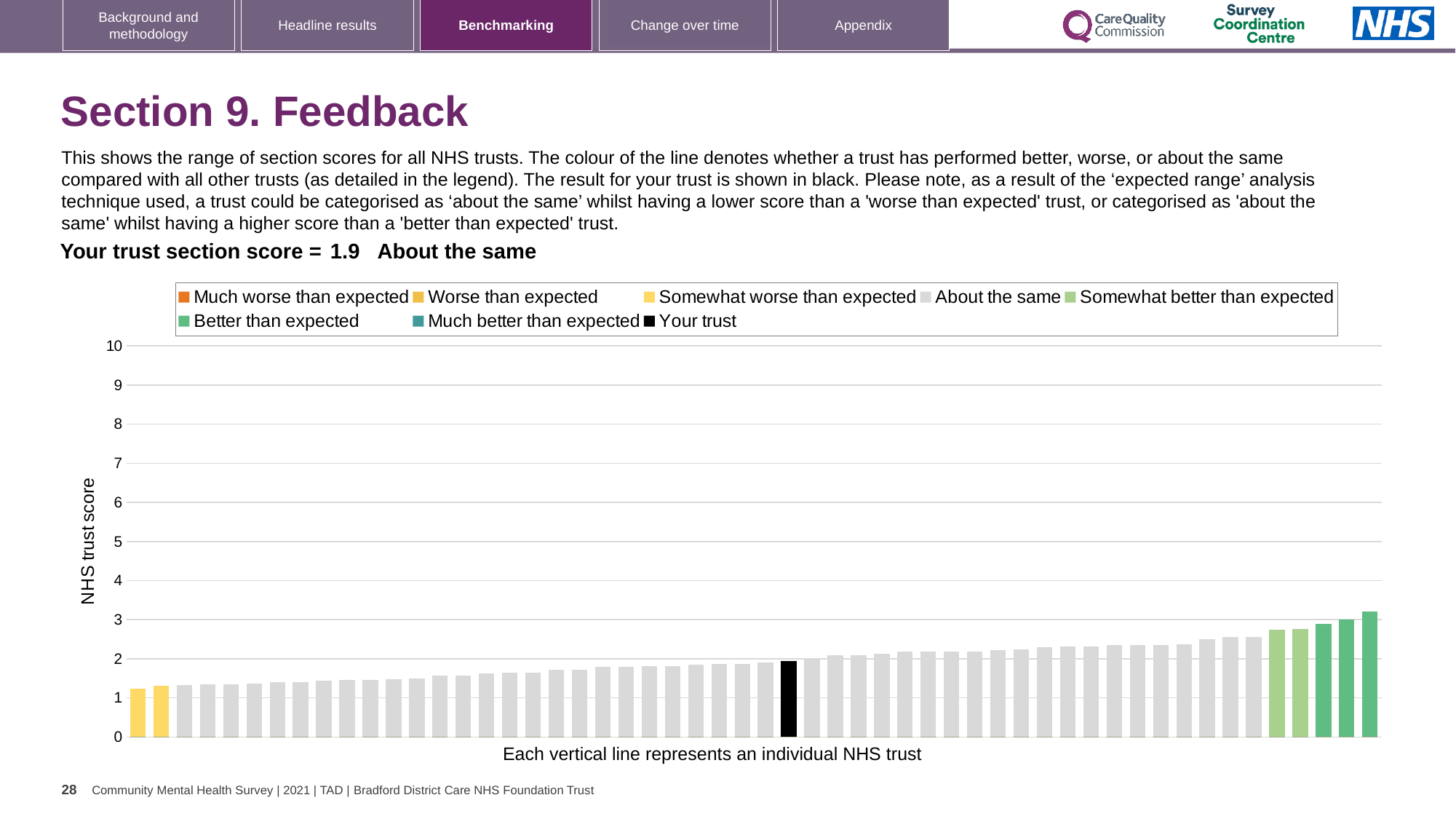
What is the label on the y axis of the chart? NHS trust score Which is larger, the leftmost bar or the rightmost bar? the rightmost bar How many entries does the chart legend list? 8 Is the value of the shortest bar greater or less than 2? less What is the section score for your trust shown on the slide? 1.9 Is the value of the tallest bar greater or less than 4? less What kind of chart is shown on the slide? bar chart Do the bar values rise or fall from left to right along the x axis? rise How many bars are coloured 'Somewhat worse than expected' (yellow)? 2 What is the highest value shown on the y axis? 10 What colour is the bar for your trust? black Is the value for your trust greater or less than 5? less